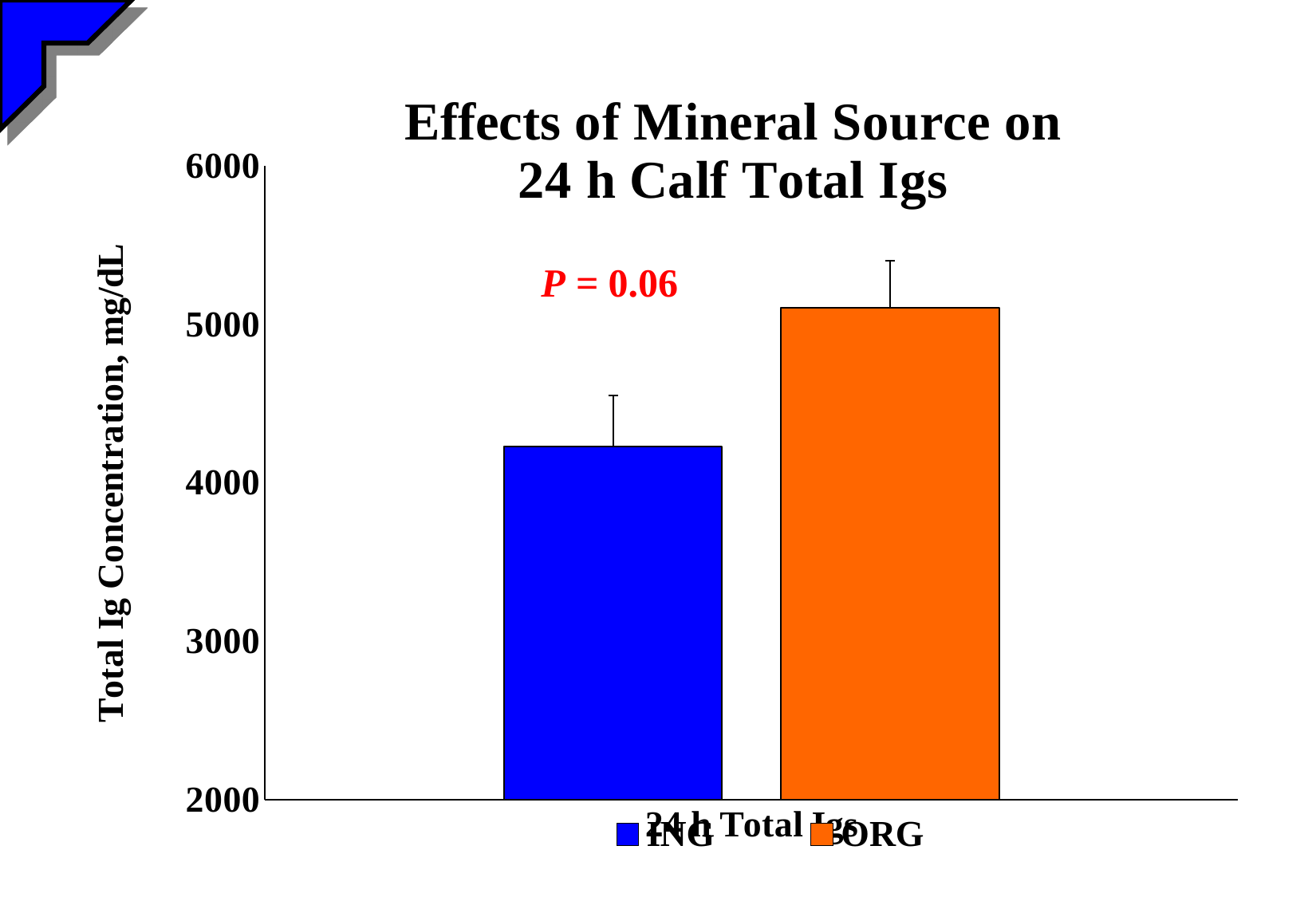
Is the value for ING greater or less than 4000? greater Which series has the highest bar in the chart? ORG Is the value for ORG greater or less than 4000? greater What P value is printed on the chart? P = 0.06 Which series has the lowest bar in the chart? ING Which series has the higher 24 h total Ig concentration, ING or ORG? ORG What is the title of the chart? Effects of Mineral Source on 24 h Calf Total Igs Is the value for ORG greater or less than 6000? less How many bars are plotted in the chart? 2 How many series does the legend list? 2 What kind of chart is shown on the slide? bar chart